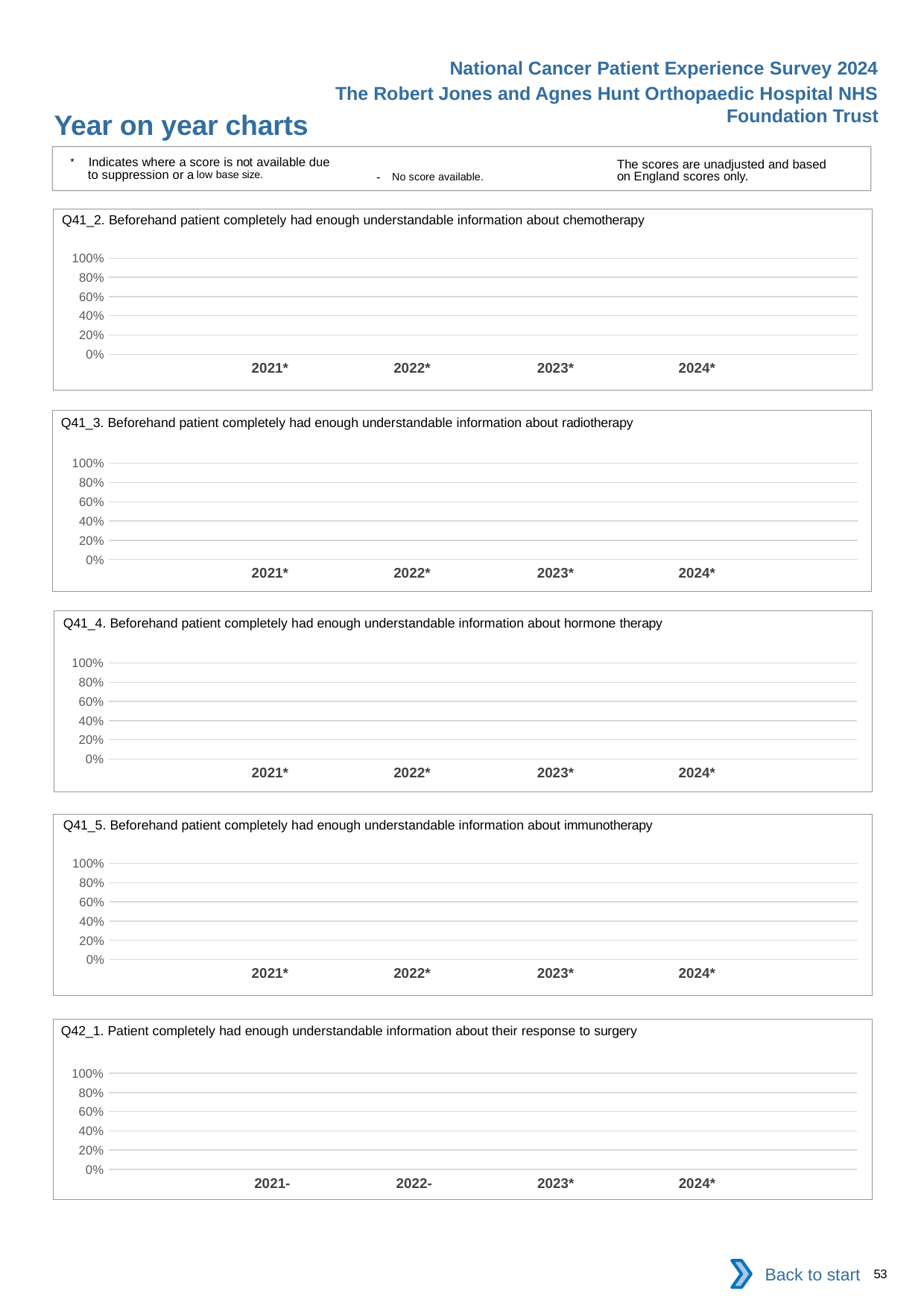
In the chart titled Q42_1, how many year categories are shown on the x axis? 4 In the chart titled Q41_5, how many data points are plotted? 0 What is the title of the bottom chart on the slide? Q42_1. Patient completely had enough understandable information about their response to surgery In the chart titled Q41_2, how many year categories are shown on the x axis? 4 In the chart titled Q41_2, is a score plotted for 2024? No In the chart titled Q41_4, what is the highest value shown on the y axis? 100% In the chart titled Q41_3, which years are listed on the x axis? 2021*, 2022*, 2023*, 2024*